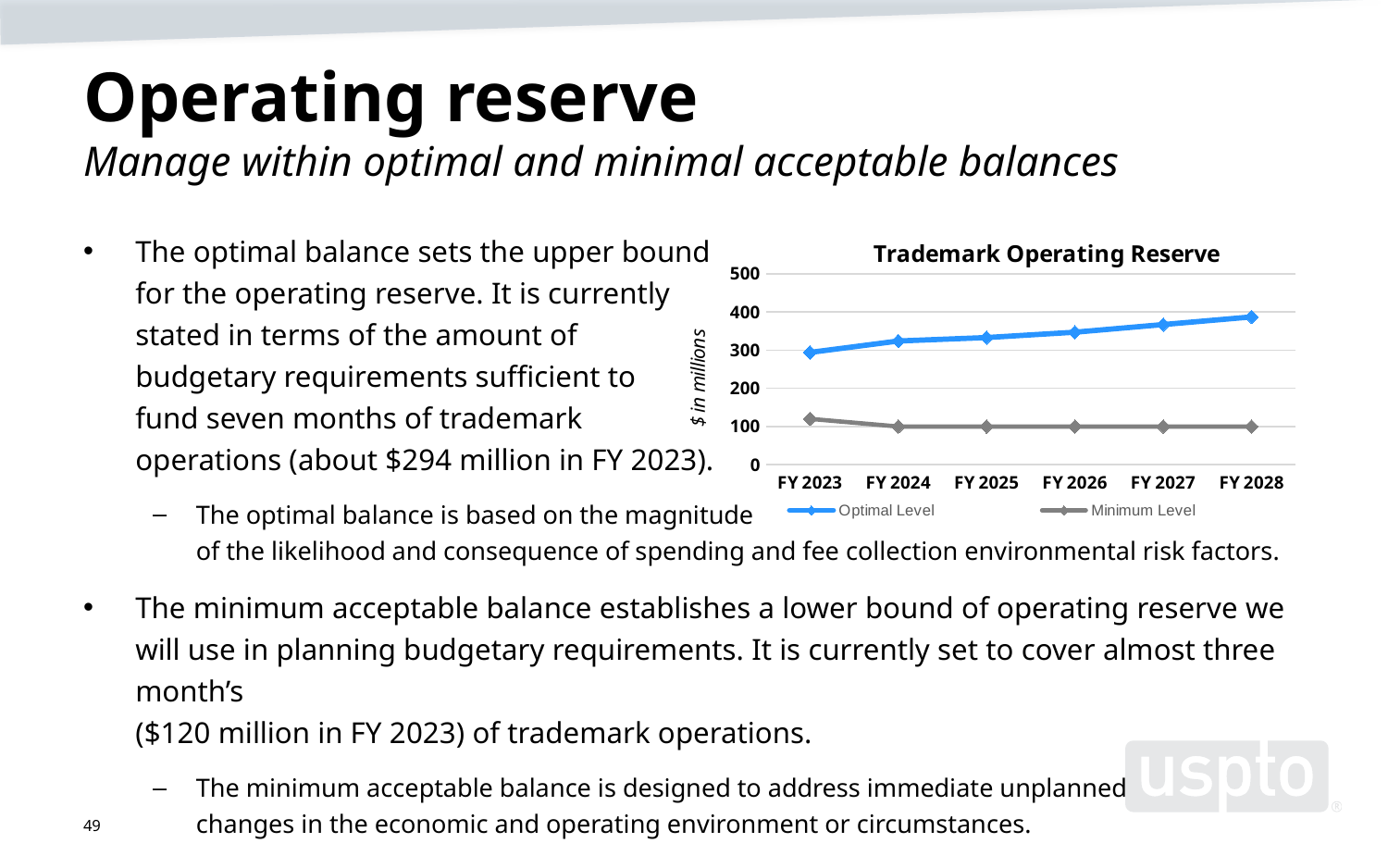
In which fiscal year is the Optimal Level highest? FY 2028 In which fiscal year is the Optimal Level lowest? FY 2023 What type of chart is shown on the slide? line chart Does the Minimum Level series rise or fall from FY 2023 to FY 2024? fall What is the label on the vertical axis of the chart? $ in millions How many series does the chart legend list? 2 How many fiscal years are plotted on the x axis of the chart? 6 Does the Optimal Level series rise or fall from FY 2023 to FY 2028? rise Is the Optimal Level value for FY 2028 greater or less than 300? greater Is the Minimum Level value for FY 2026 greater or less than 200? less In FY 2025, which series has the larger value, Optimal Level or Minimum Level? Optimal Level What is the title of the chart? Trademark Operating Reserve